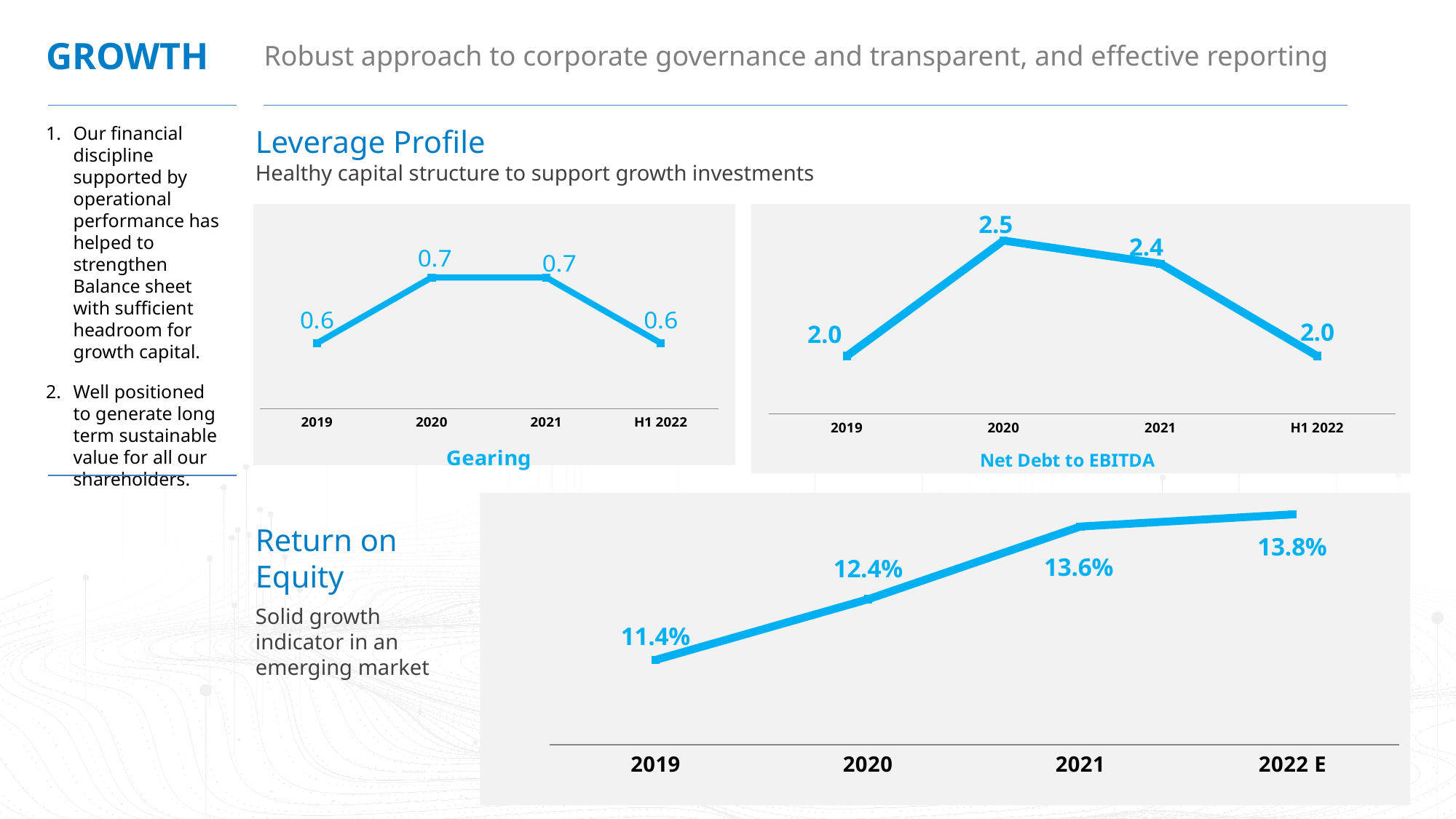
What type of chart is the Net Debt to EBITDA chart? line chart In the Gearing chart, what is the value for H1 2022? 0.6 In the Net Debt to EBITDA chart, is the value for 2021 larger or smaller than the value for H1 2022? larger In the Net Debt to EBITDA chart, which year has the highest value? 2020 In the Net Debt to EBITDA chart, what is the difference between the 2020 value and the 2019 value? 0.5 In the Return on Equity chart, do the values rise or fall from 2019 to 2022 E? rise In the Return on Equity chart, what is the value for 2021? 13.6% In the Return on Equity chart, what is the difference between the 2022 E value and the 2019 value? 2.4% In the Net Debt to EBITDA chart, what is the value for 2021? 2.4 In the Gearing chart, what is the value for 2020? 0.7 In the Return on Equity chart, which year has the lowest value? 2019 How many data points are plotted in the Gearing chart? 4